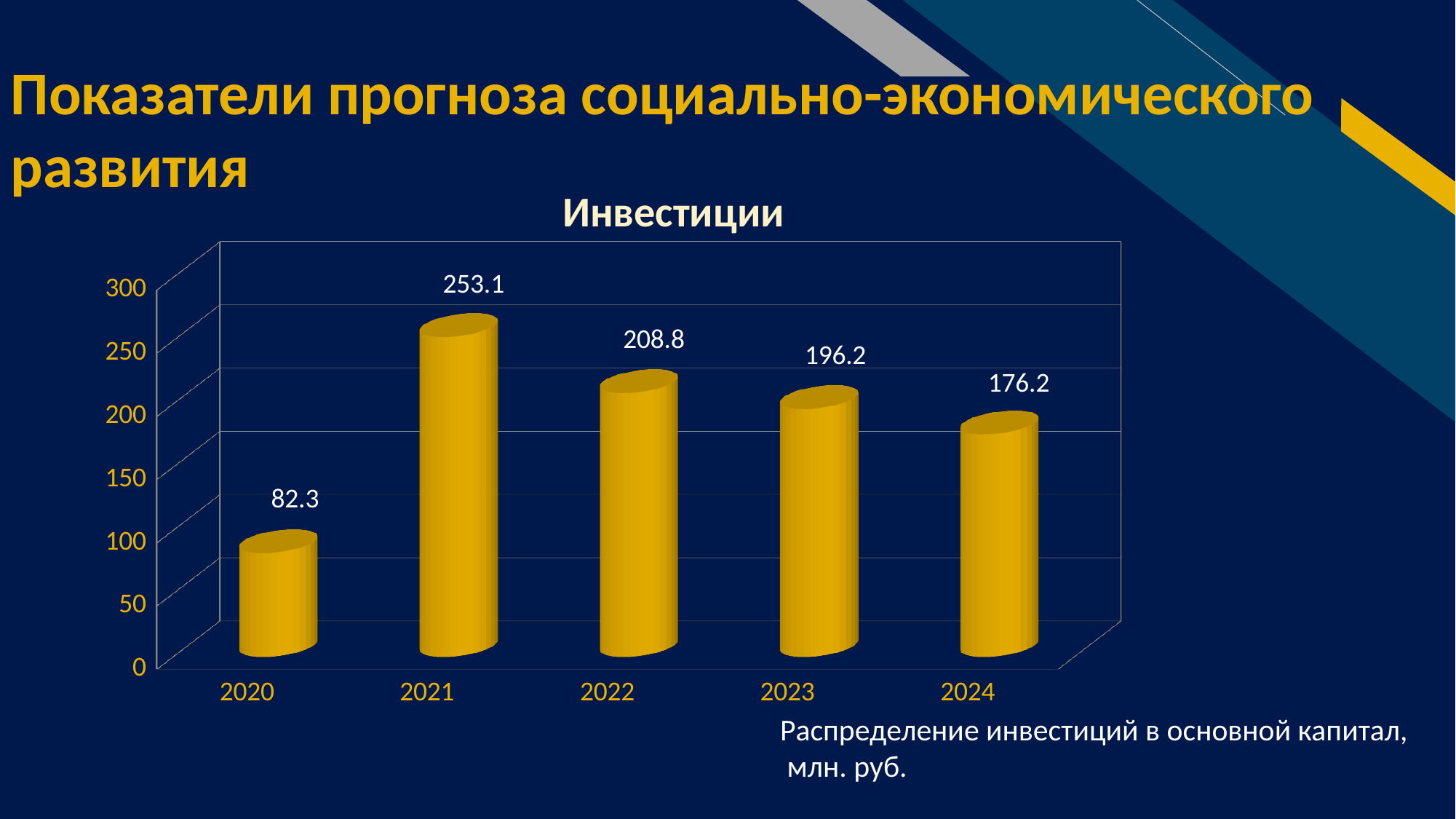
What is the value for 2021 in the Инвестиции chart? 253.1 Which year has the highest value in the Инвестиции chart? 2021 How many years are shown on the x axis of the chart? 5 What is the value for 2020 in the Инвестиции chart? 82.3 Is the value for 2023 greater or less than 150? greater What is the difference between the values for 2021 and 2020? 170.8 What is the difference between the values for 2022 and 2023? 12.6 What kind of chart is shown on the slide? bar chart What is the value for 2024 in the Инвестиции chart? 176.2 Which year has the lowest value in the Инвестиции chart? 2020 Which is larger, the value for 2022 or the value for 2024? 2022 What is the title of the chart? Инвестиции